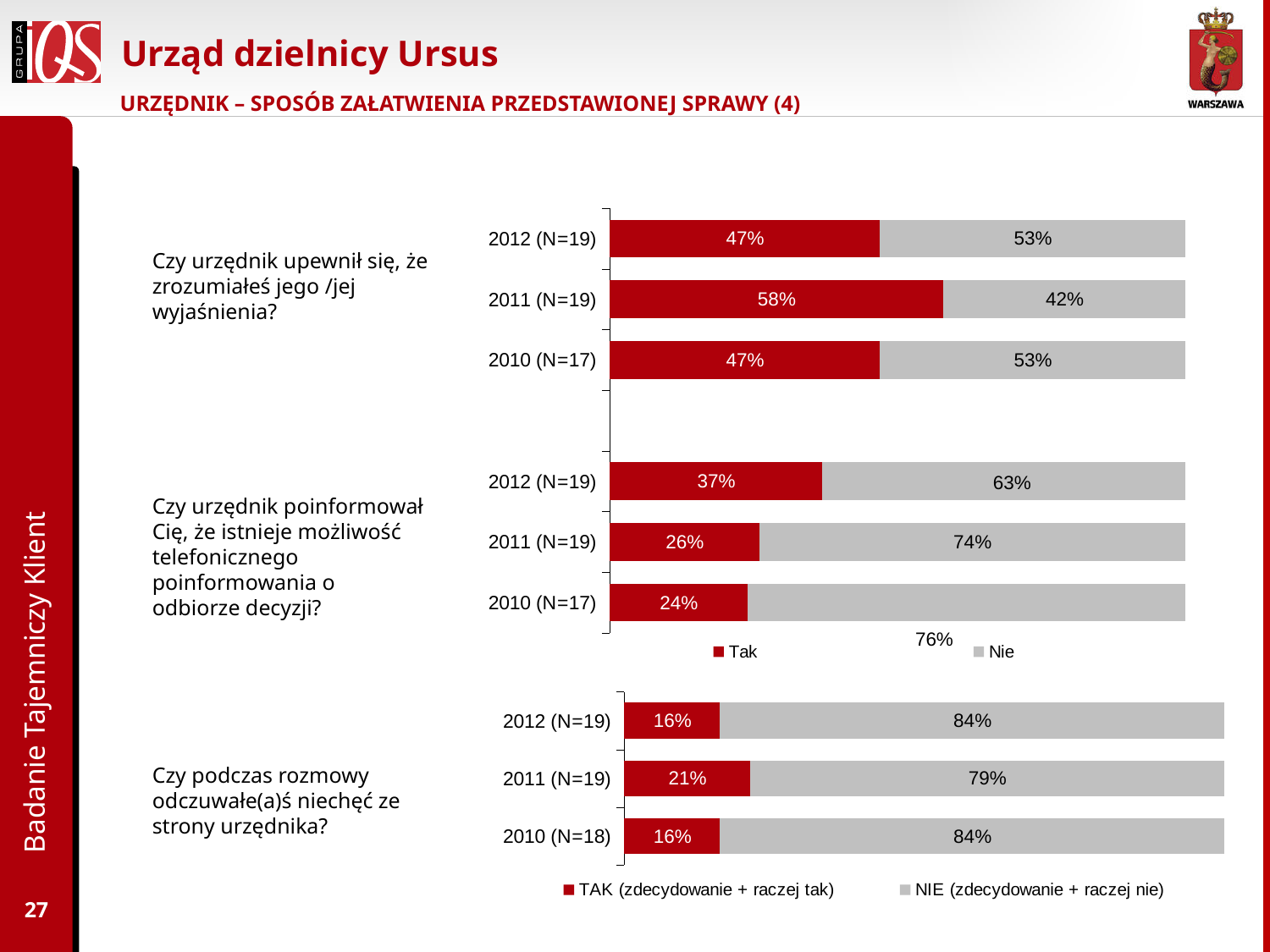
In the middle chart ("Czy urzędnik poinformował Cię..."), does the Tak share rise or fall from 2010 to 2012? rise What kind of chart is used on this slide? stacked bar chart In the top chart ("Czy urzędnik upewnił się, że zrozumiałeś jego/jej wyjaśnienia?"), what is the Tak value for 2011 (N=19)? 58% In the top chart ("Czy urzędnik upewnił się..."), what is the Nie value for 2010 (N=17)? 53% In the bottom chart ("Czy podczas rozmowy odczuwałe(a)ś niechęć..."), what is the NIE value for 2012 (N=19)? 84% In the bottom chart ("Czy podczas rozmowy odczuwałe(a)ś niechęć..."), which is larger: the TAK value for 2011 or for 2010? 2011 In the top chart ("Czy urzędnik upewnił się..."), which year has the highest Tak share? 2011 (N=19) In the bottom chart ("Czy podczas rozmowy odczuwałe(a)ś niechęć ze strony urzędnika?"), what is the TAK value for 2011 (N=19)? 21% How many series does the legend of the bottom chart list? 2 In the middle chart ("Czy urzędnik poinformował Cię..."), what is the difference between the Tak values for 2012 and 2011? 11 percentage points In the middle chart ("Czy urzędnik poinformował Cię..."), which year has the lowest Tak share? 2010 (N=17) In the middle chart ("Czy urzędnik poinformował Cię, że istnieje możliwość telefonicznego poinformowania o odbiorze decyzji?"), what is the Tak value for 2012 (N=19)? 37%